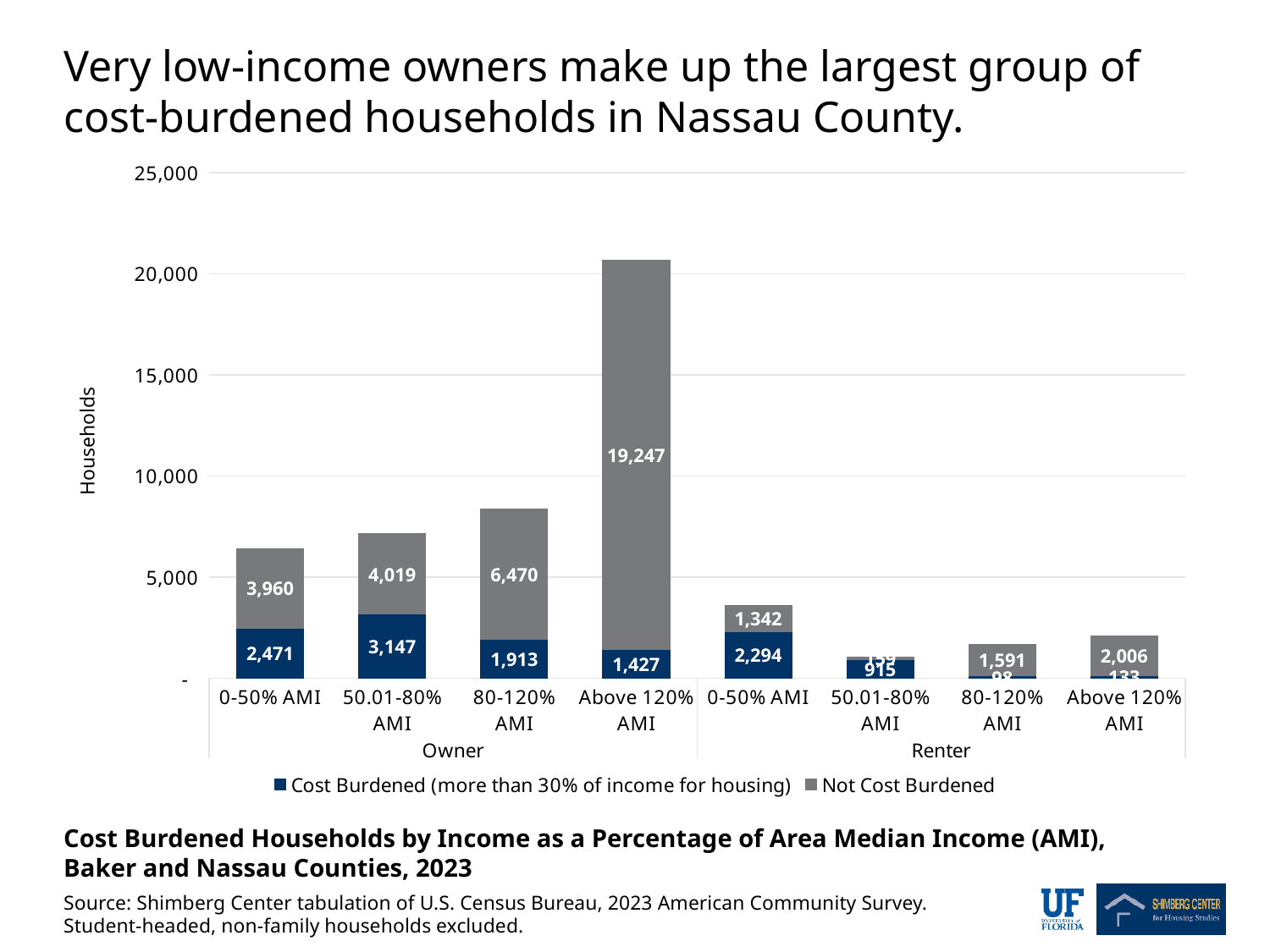
Which category has the highest number of Cost Burdened households? Owner 50.01-80% AMI What is the difference between Not Cost Burdened owner households in the 80-120% AMI category and the 50.01-80% AMI category? 2,451 What is the total height of the Owner 0-50% AMI bar (Cost Burdened plus Not Cost Burdened)? 6,431 How many series does the legend list? 2 How many income categories (bars) are plotted in the chart? 8 Which is larger: Cost Burdened owner households at 0-50% AMI or Cost Burdened renter households at 0-50% AMI? Cost Burdened owner households at 0-50% AMI Which category has the tallest total bar? Owner Above 120% AMI Is the total for the Owner Above 120% AMI bar greater or less than 20,000? greater What is the number of Cost Burdened renter households in the 0-50% AMI category? 2,294 What type of chart is shown on the slide? stacked bar chart What is the number of Not Cost Burdened owner households in the Above 120% AMI category? 19,247 What is the number of Cost Burdened owner households in the 0-50% AMI category? 2,471